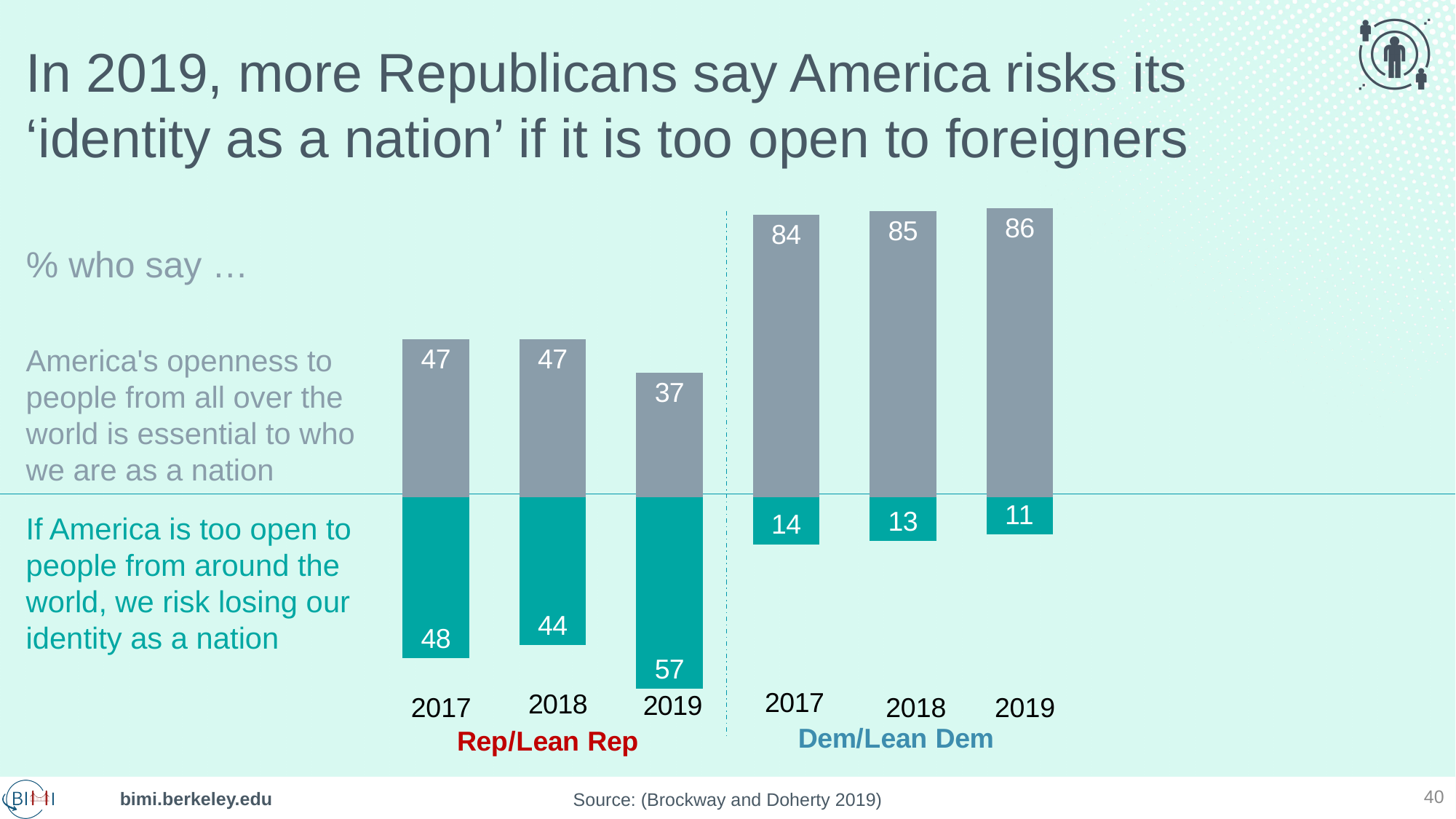
How many years are shown for each party group in the chart? 3 What is the difference between the share of Rep/Lean Rep and the share of Dem/Lean Dem in 2019 who say America's openness is essential to who we are as a nation? 49 From 2017 to 2019, does the share of Dem/Lean Dem saying that if America is too open we risk losing our identity as a nation rise or fall? Fall How many response categories (series) does the chart show? 2 Among Dem/Lean Dem, which year has the highest share saying America's openness is essential to who we are as a nation? 2019 In 2017, which group has a larger share saying that if America is too open we risk losing our identity as a nation, Rep/Lean Rep or Dem/Lean Dem? Rep/Lean Rep What percentage of Rep/Lean Rep in 2018 say America's openness is essential to who we are as a nation? 47 What percentage of Rep/Lean Rep in 2019 say that if America is too open to people from around the world, we risk losing our identity as a nation? 57 What percentage of Dem/Lean Dem in 2017 say America's openness to people from all over the world is essential to who we are as a nation? 84 What kind of chart is shown on the slide? Bar chart Among Rep/Lean Rep, which year has the lowest share saying that if America is too open we risk losing our identity as a nation? 2018 What percentage of Dem/Lean Dem in 2019 say that if America is too open we risk losing our identity as a nation? 11